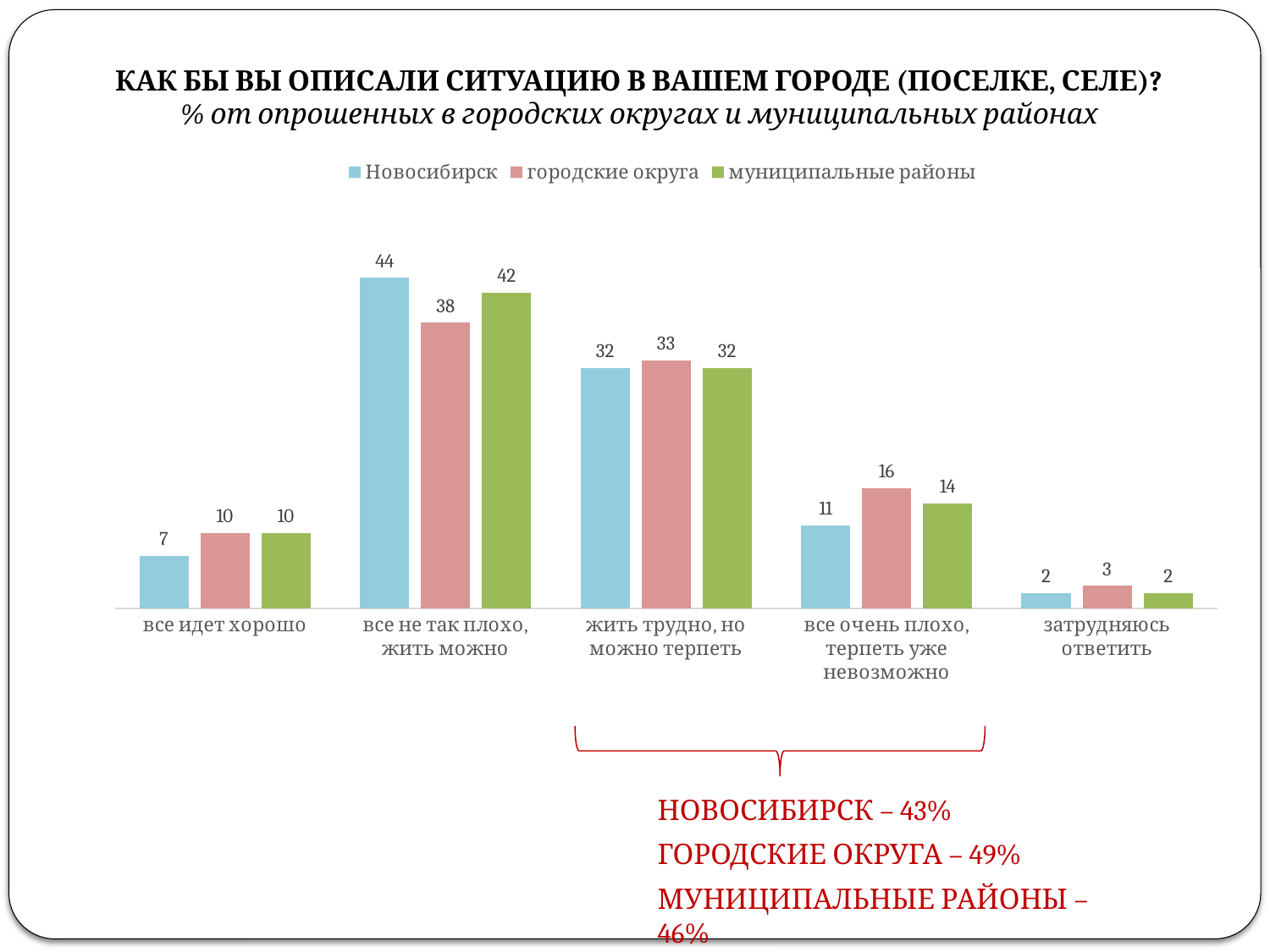
In the category "все очень плохо, терпеть уже невозможно", which is larger: the value for Новосибирск or for муниципальные районы? муниципальные районы What type of chart is shown on the slide? bar chart Which series is shown in blue in the legend? Новосибирск How many series does the legend list? 3 What is the difference between the Новосибирск and городские округа values in the category "все не так плохо, жить можно"? 6 How many categories are shown on the x axis? 5 Which category has the highest value for Новосибирск? все не так плохо, жить можно What is the value for городские округа in the category "все очень плохо, терпеть уже невозможно"? 16 What is the value for муниципальные районы in the category "все идет хорошо"? 10 What is the value for Новосибирск in the category "все не так плохо, жить можно"? 44 What is the value for городские округа in the category "жить трудно, но можно терпеть"? 33 Which category has the lowest value for городские округа? затрудняюсь ответить